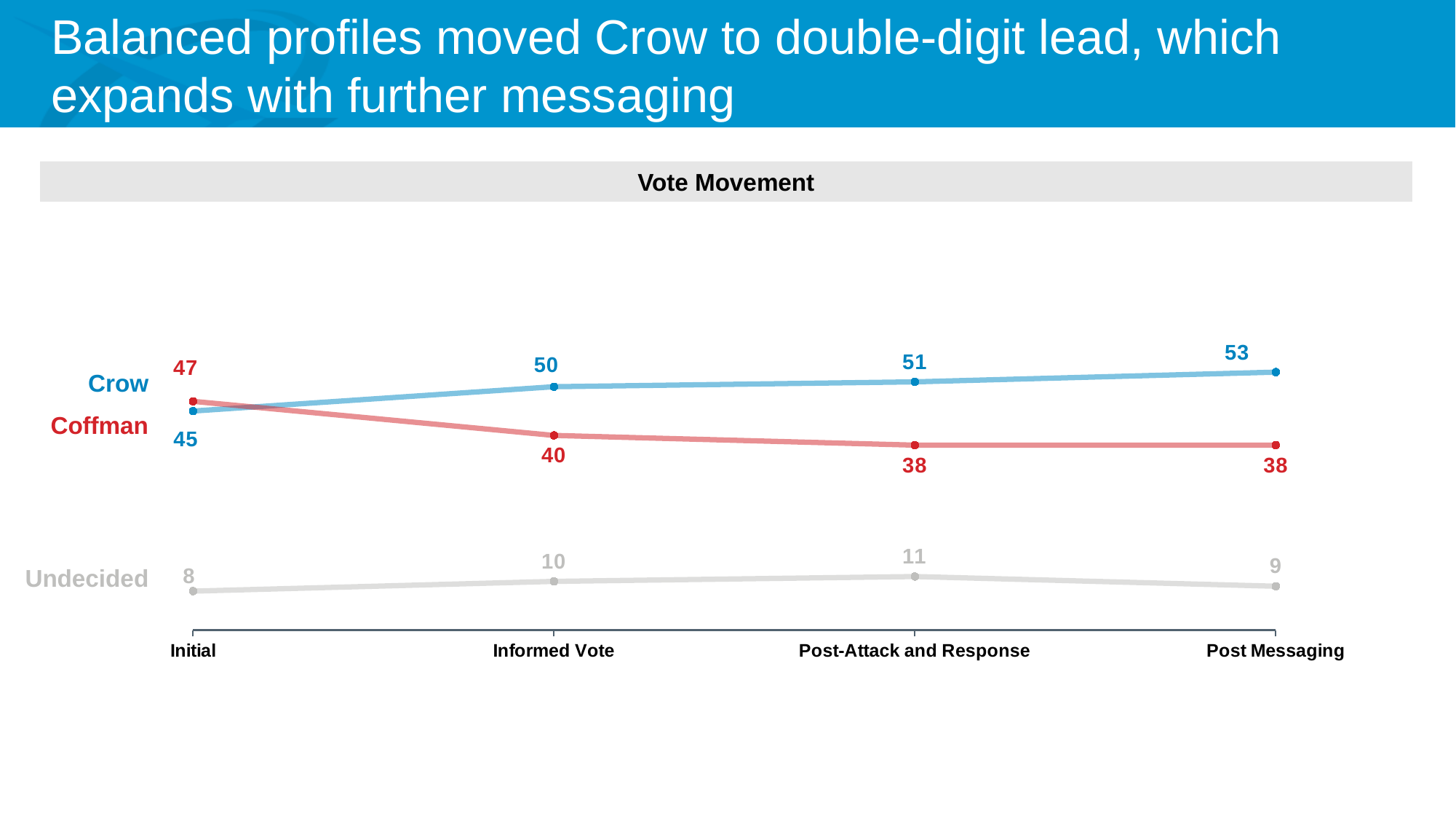
What kind of chart is shown? Line chart What is the Undecided value at the Post-Attack and Response stage? 11 Who has the higher value at the Initial stage, Crow or Coffman? Coffman How many series are plotted on the chart? 3 What is the difference between Crow and Coffman at the Post Messaging stage? 15 What is Coffman's value at the Initial stage? 47 At which stage is the Undecided value lowest? Initial What is Crow's value at the Post Messaging stage? 53 How many stages are shown on the x axis? 4 What is the title of the chart? Vote Movement Does Coffman's value rise or fall from Initial to Post Messaging? Fall At which stage is Crow's value highest? Post Messaging